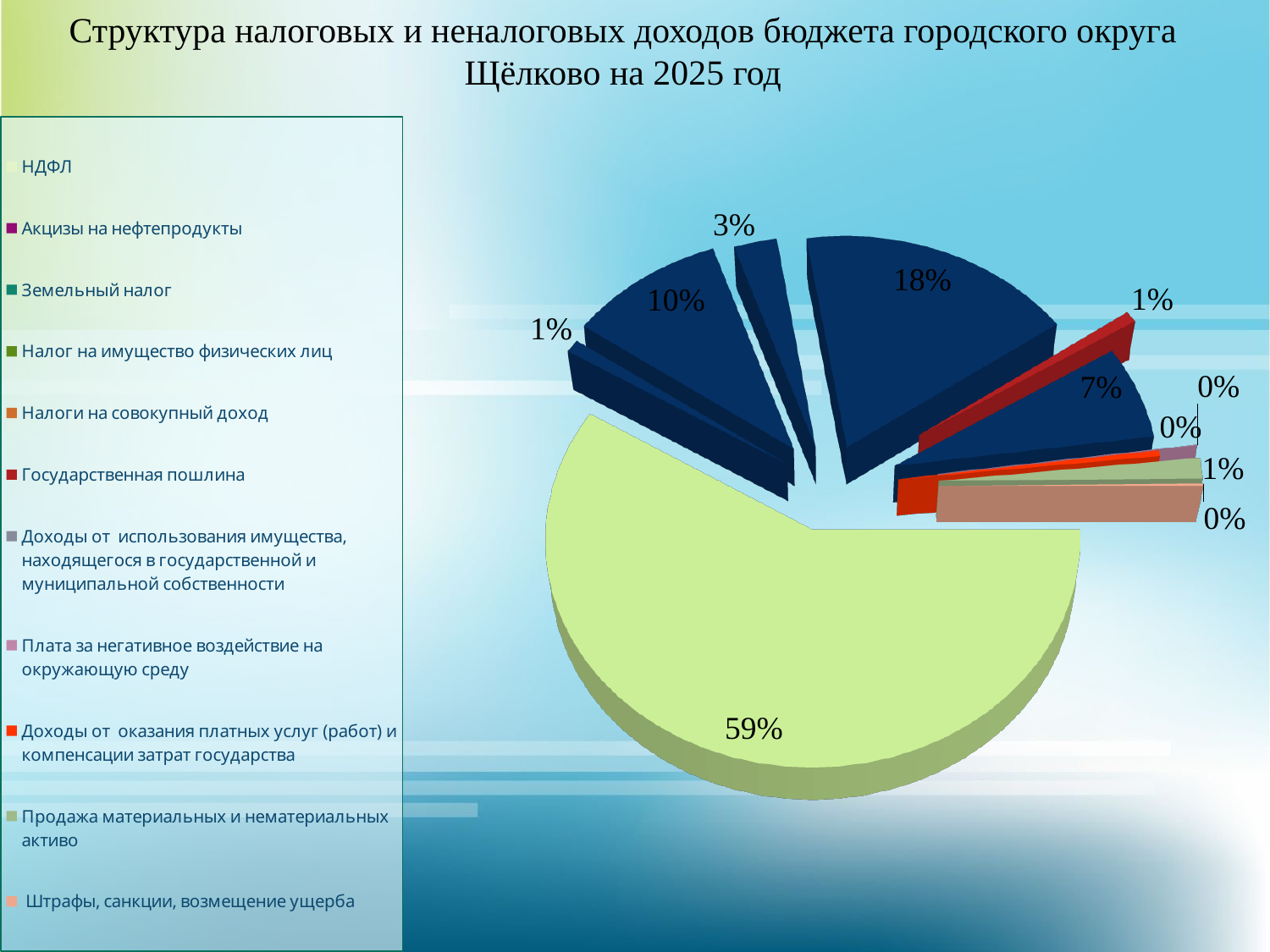
How many slices of the pie chart are labelled 0%? 3 What is the combined share of the slices labelled 59% and 18%? 77% What is the smallest share shown as a data label on the pie chart? 0% What is the share of the largest slice of the pie chart? 59% What is the title of the chart on the slide? Структура налоговых и неналоговых доходов бюджета городского округа Щёлково на 2025 год What kind of chart is shown on the slide? pie chart Is the largest slice of the pie chart greater or less than 50%? greater What is the share of the second-largest slice of the pie chart? 18% Which is larger on the pie chart: the slice labelled 7% or the slice labelled 10%? 10% How many slices of the pie chart are labelled 1%? 3 What is the difference between the 18% slice and the 10% slice of the pie chart? 8% How many entries does the legend of the pie chart list? 11